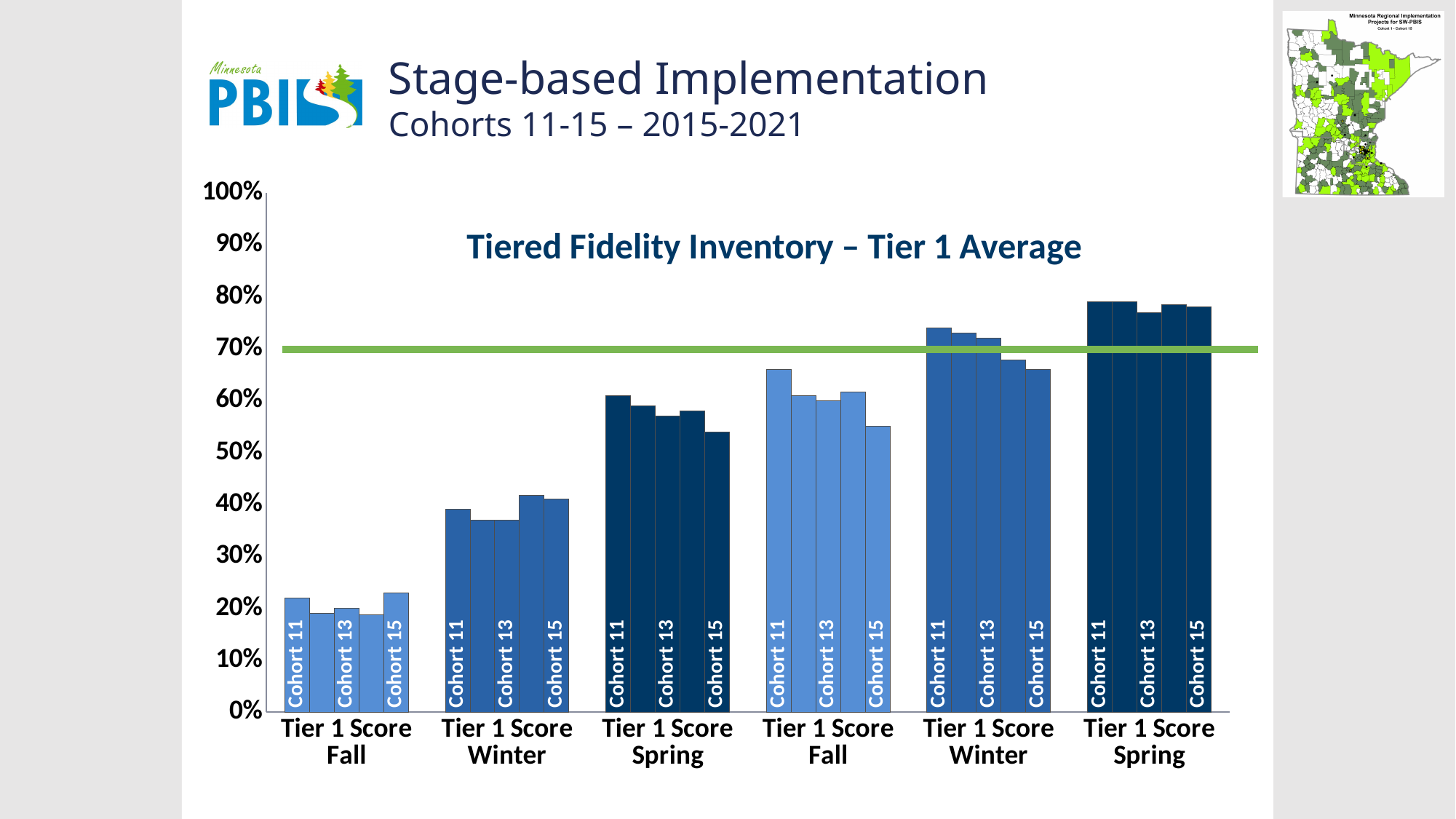
What is the title of the chart? Tiered Fidelity Inventory – Tier 1 Average How many bars are in each category group of the chart? 5 Which category group has the highest bars in the chart? Tier 1 Score Spring (the rightmost group) Is the value for Cohort 11 in the leftmost Tier 1 Score Fall group greater or less than 30%? less Do the bar values generally rise or fall from left to right across the chart? Rise What kind of chart is shown on the slide? Bar chart Which category group has the lowest bars in the chart? Tier 1 Score Fall (the leftmost group) Is the value for Cohort 11 in the second Tier 1 Score Fall group greater or less than 70%? less At what value does the green horizontal line cross the y axis? 70% Which is larger: the value for Cohort 11 in the leftmost Tier 1 Score Fall group or the value for Cohort 11 in the rightmost Tier 1 Score Spring group? Cohort 11 in the rightmost Tier 1 Score Spring group How many category groups are shown along the x axis of the chart? 6 Is the value for Cohort 11 in the rightmost Tier 1 Score Spring group greater or less than 70%? greater